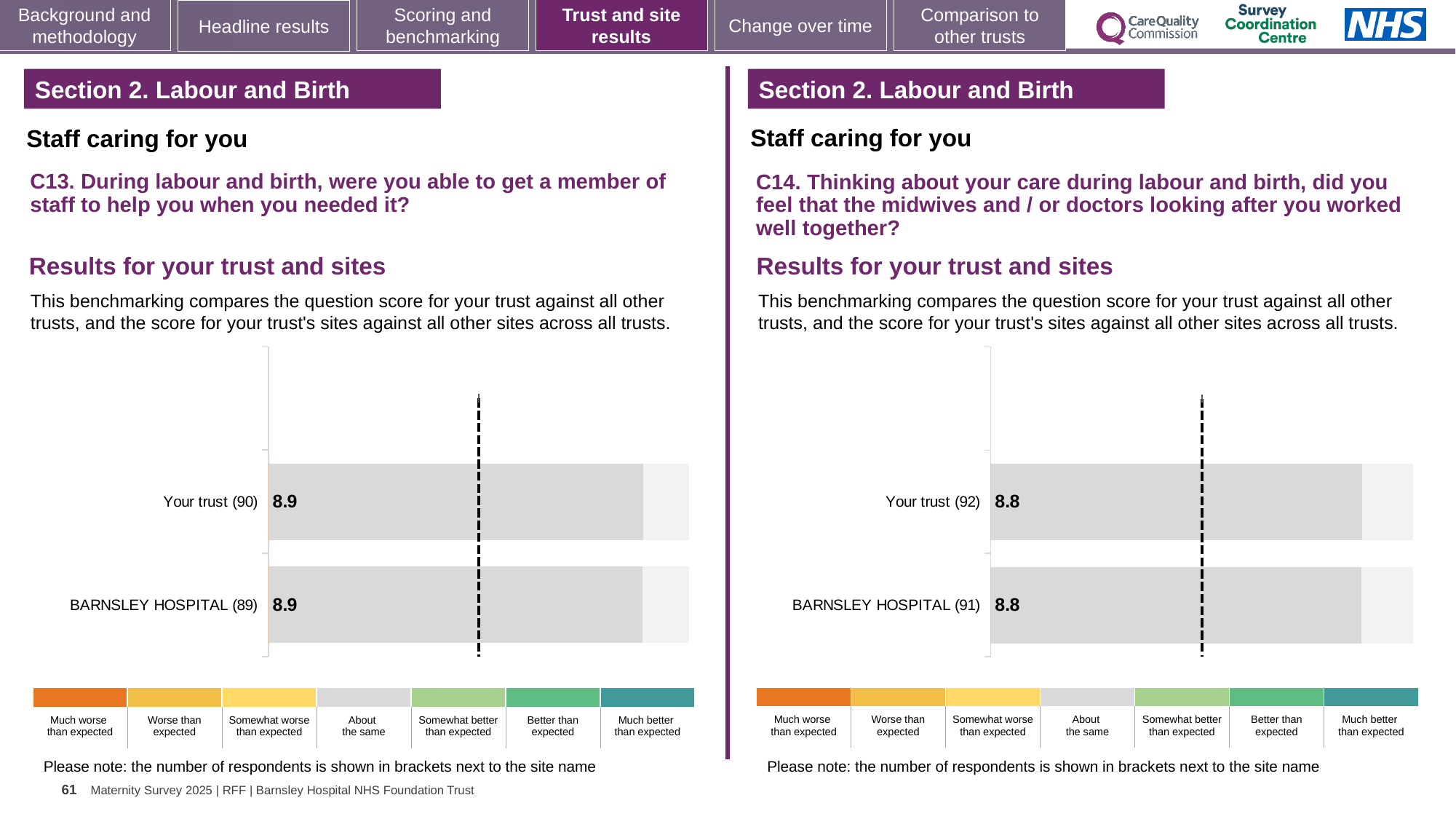
What is the difference between the Your trust score in the C13 chart on the left and the Your trust score in the C14 chart on the right? 0.1 In the C14 chart on the right, how many respondents are shown in brackets for BARNSLEY HOSPITAL? 91 In the C13 chart on the left, what is the score for Your trust? 8.9 In the C13 chart on the left, is the score for Your trust the same as the score for BARNSLEY HOSPITAL? Yes In the C13 chart on the left, how many respondents are shown in brackets for Your trust? 90 In the C13 chart on the left, what is the score for BARNSLEY HOSPITAL? 8.9 How many categories does the colour key below the C13 chart on the left list? 7 In the C14 chart on the right, what is the score for Your trust? 8.8 What kind of chart is used in the C13 chart on the left? Bar chart How many bars are plotted in the C14 chart on the right? 2 What is the label of the middle category in the colour key below the C14 chart on the right? About the same In the C14 chart on the right, what is the score for BARNSLEY HOSPITAL? 8.8